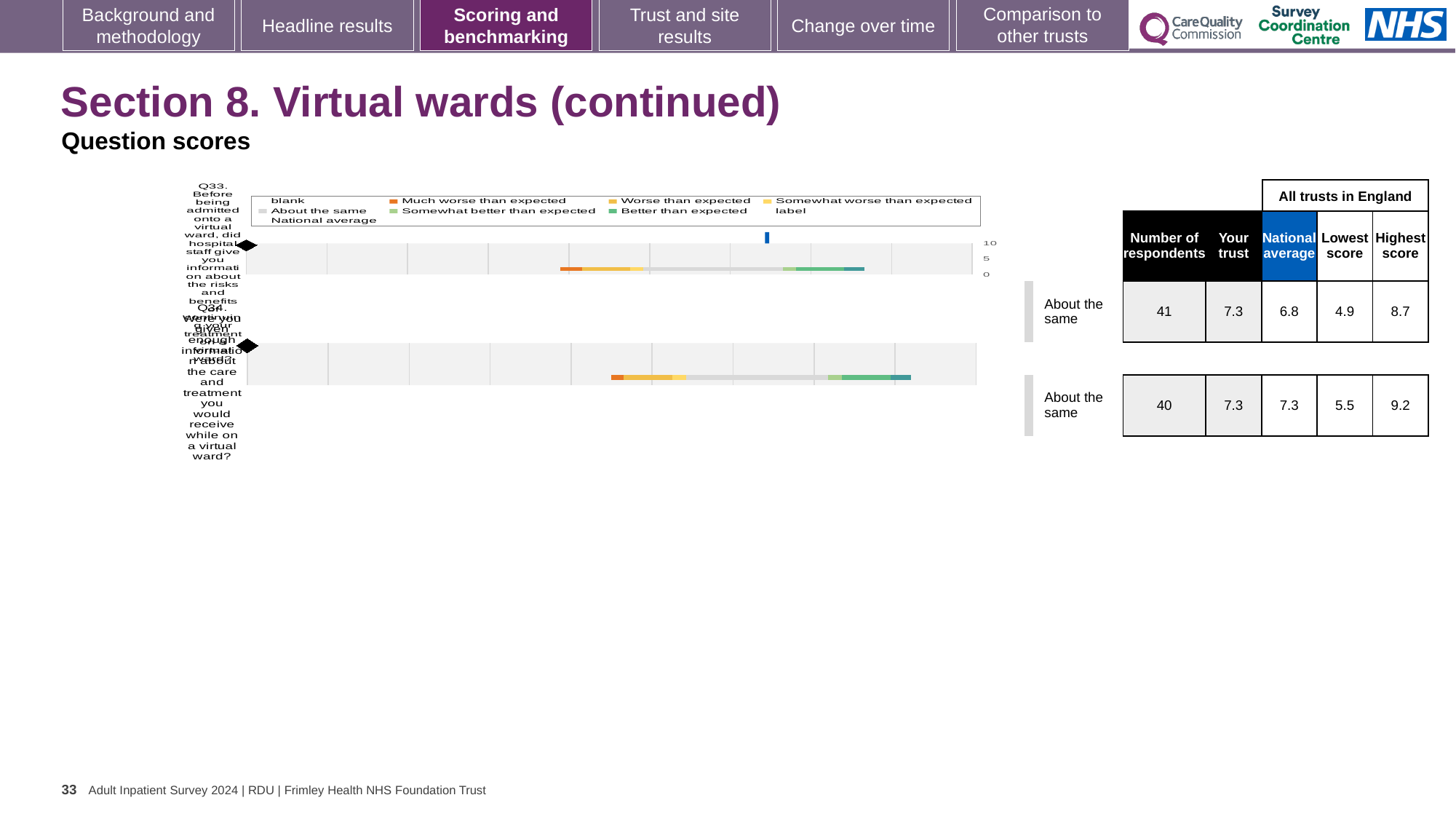
For Q33, which is larger: the 'Your trust' score or the national average? Your trust According to the table beside the chart, what is the national average for Q33? 6.8 How many entries does the chart's legend list? 9 What is the difference between the highest score and the lowest score for Q34 in the table beside the chart? 3.7 According to the table beside the chart, what is the 'Your trust' score for Q33? 7.3 What benchmark category is shown next to the chart for both Q33 and Q34? About the same What is the difference between the highest score and the lowest score for Q33 in the table beside the chart? 3.8 In the chart's legend, which entry is shown in orange? Much worse than expected According to the table beside the chart, what is the highest score among all trusts in England for Q34? 9.2 What kind of chart is shown on the slide? bar chart How many question bars (Q33 and Q34) are plotted in the chart? 2 According to the table beside the chart, how many respondents answered Q34? 40